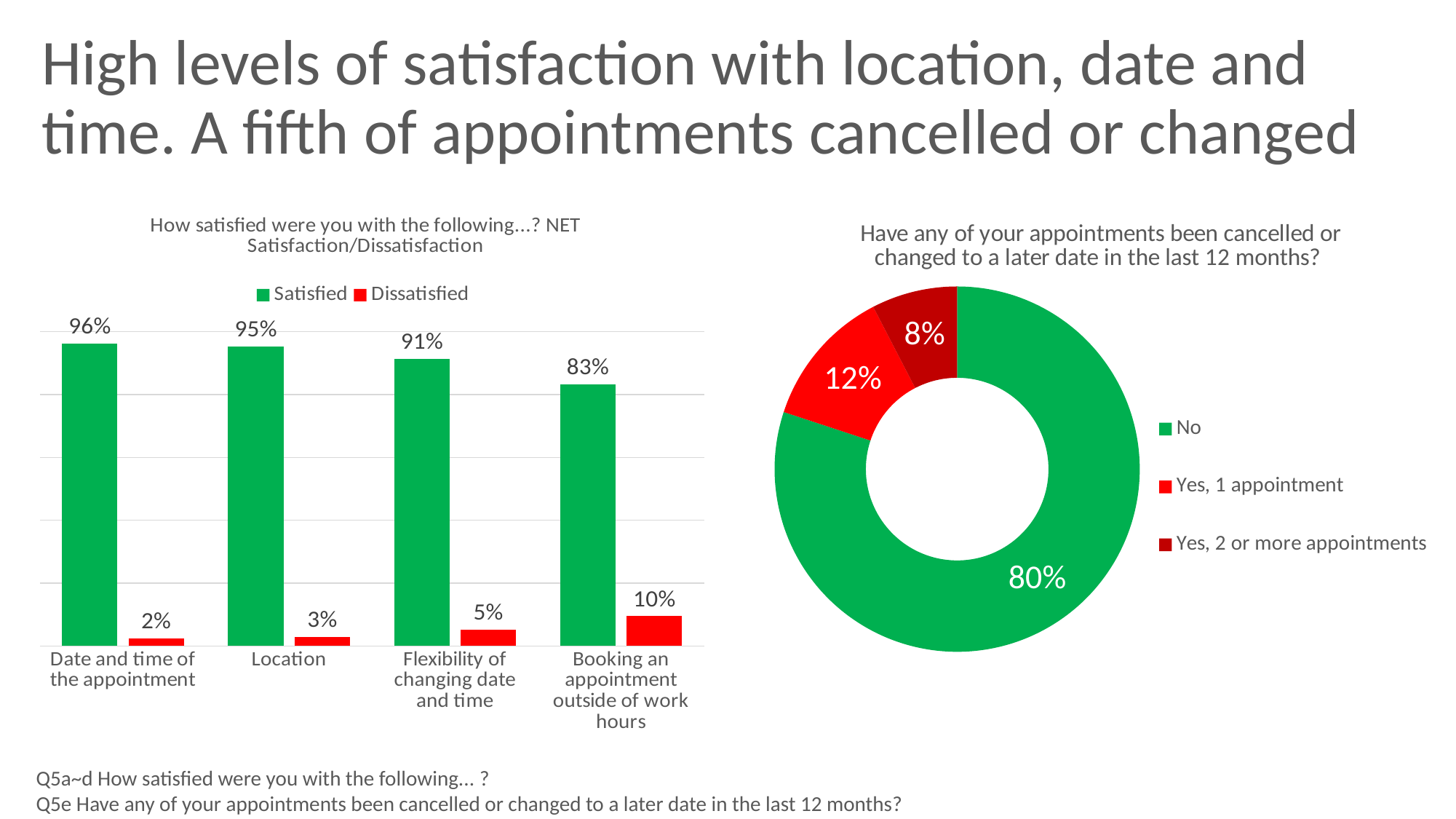
In the bar chart on the left, do the Satisfied values rise or fall from left to right? Fall In the bar chart on the left, which category has the lowest Satisfied value? Booking an appointment outside of work hours In the bar chart on the left, how many series does the legend list? 2 In the bar chart on the left, what is the difference between the Satisfied values for Date and time of the appointment and Booking an appointment outside of work hours? 13% In the doughnut chart on the right, which category has the largest share? No In the bar chart on the left, how many categories are shown? 4 What kind of chart is on the left of the slide? Bar chart In the bar chart on the left, what is the Dissatisfied value for Booking an appointment outside of work hours? 10% In the doughnut chart on the right, what share of respondents answered 'Yes, 1 appointment'? 12% In the bar chart on the left, which is larger: the Dissatisfied value for Location or for Flexibility of changing date and time? Flexibility of changing date and time In the bar chart on the left, what is the Satisfied value for Location? 95% In the bar chart on the left, which category has the highest Satisfied value? Date and time of the appointment